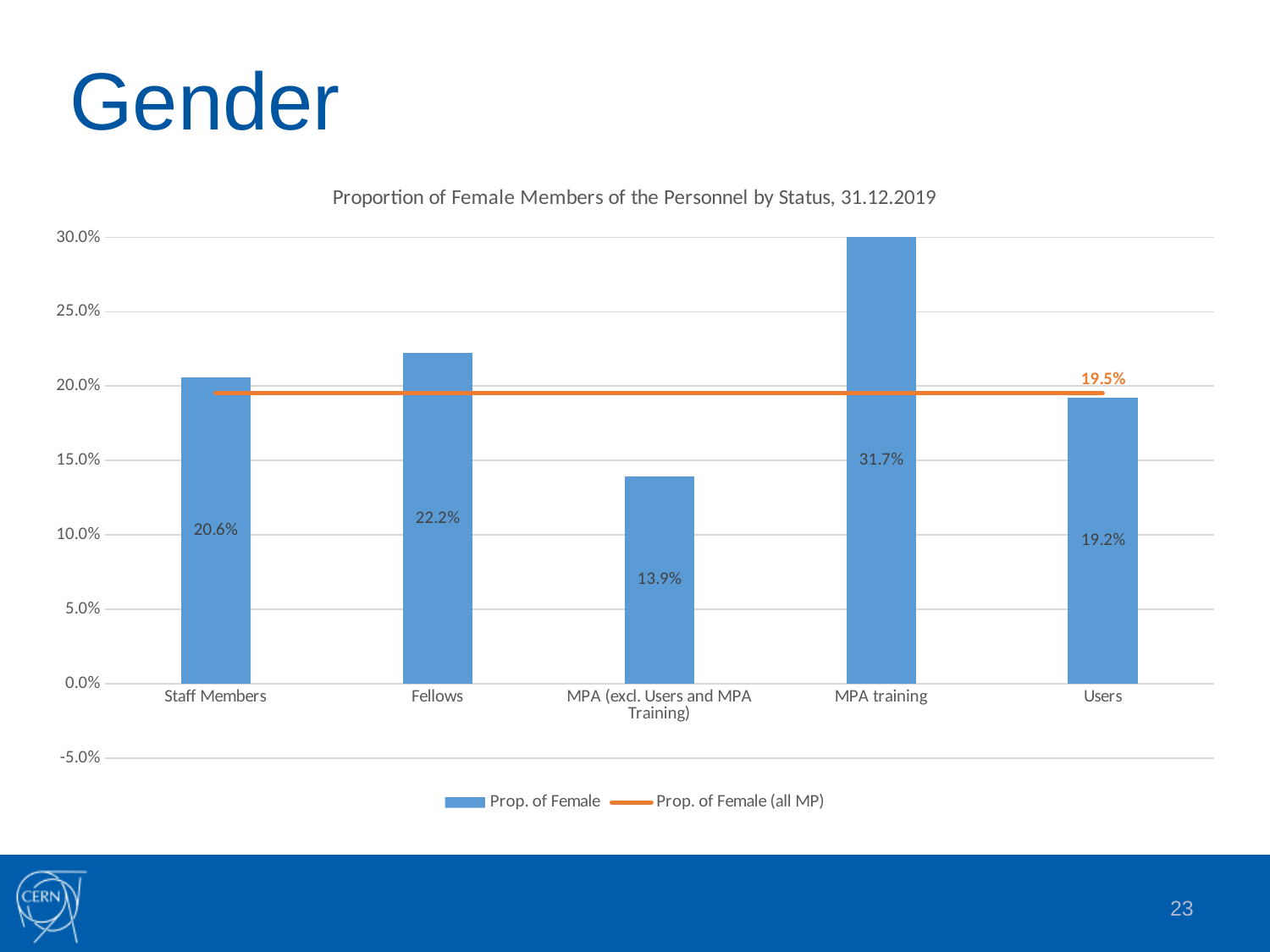
Which status has the highest proportion of female members? MPA training What is the difference between the proportion of female MPA training members and female Users? 12.5% What is the proportion of female Staff Members shown on the chart? 20.6% Which status has the lowest proportion of female members? MPA (excl. Users and MPA Training) How many status categories are shown on the x axis? 5 What is the proportion of female Fellows shown on the chart? 22.2% What value is shown for MPA (excl. Users and MPA Training)? 13.9% What is the title of the chart? Proportion of Female Members of the Personnel by Status, 31.12.2019 What value is shown for the Prop. of Female (all MP) line? 19.5% Which is larger, the proportion of female Fellows or female Staff Members? Fellows How many series does the legend list? 2 Is the value for Users greater or less than 20.0%? less